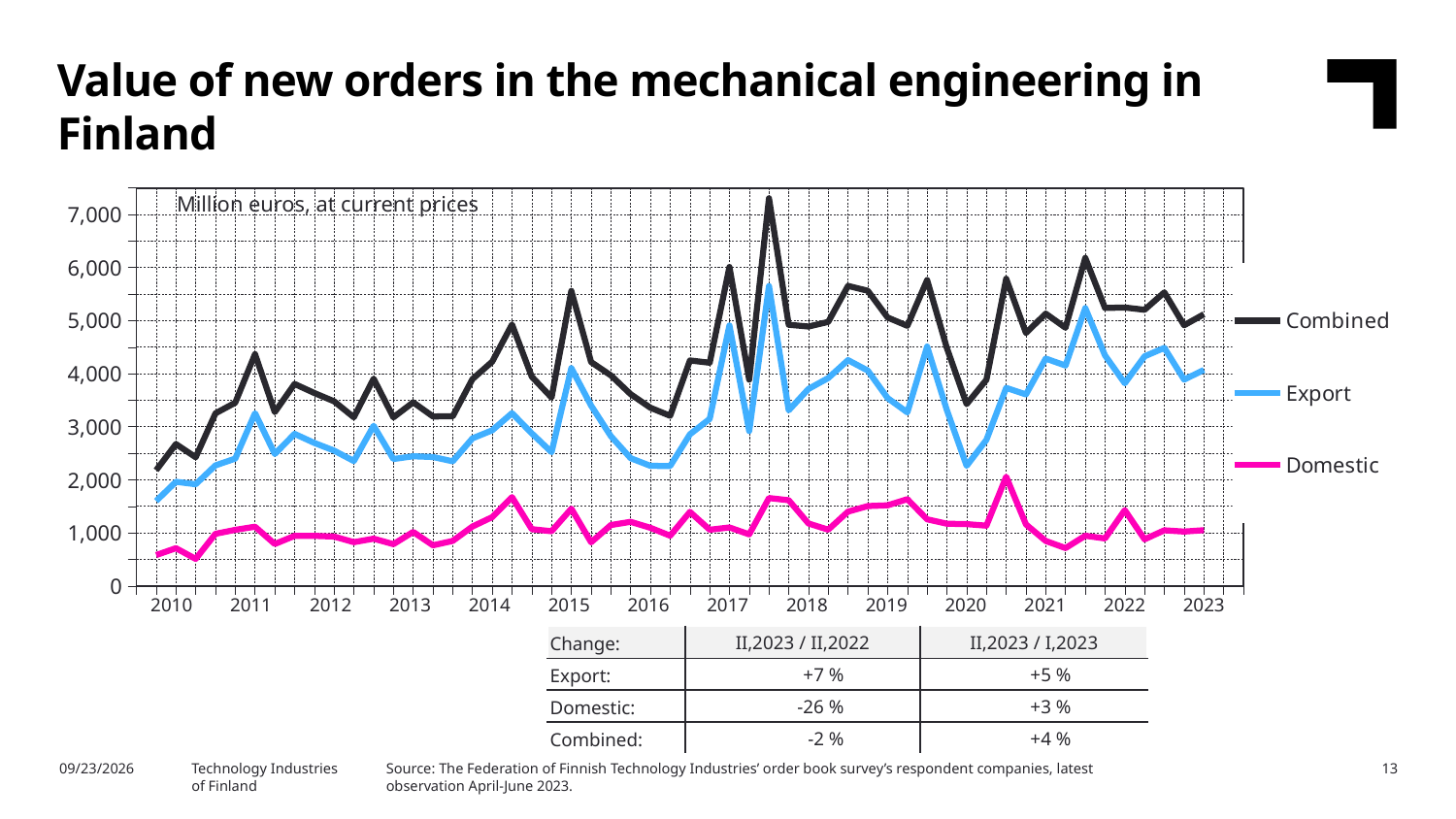
Is the peak value of the Combined series in 2017 greater or less than 7,000? greater Is the Domestic series value at the start of 2010 greater or less than 1,000? less Is the Export series value at the start of 2010 greater or less than 2,000? less What unit is stated in the chart's subtitle? Million euros, at current prices Does the Combined series generally rise or fall from 2010 to 2023? rise How many series does the legend list? 3 Which is larger at the end of 2023: the Export value or the Domestic value? Export Which series is plotted in black? Combined What kind of chart is shown on the slide? Line chart Which series has the highest values throughout the chart? Combined Which series has the lowest values throughout the chart? Domestic